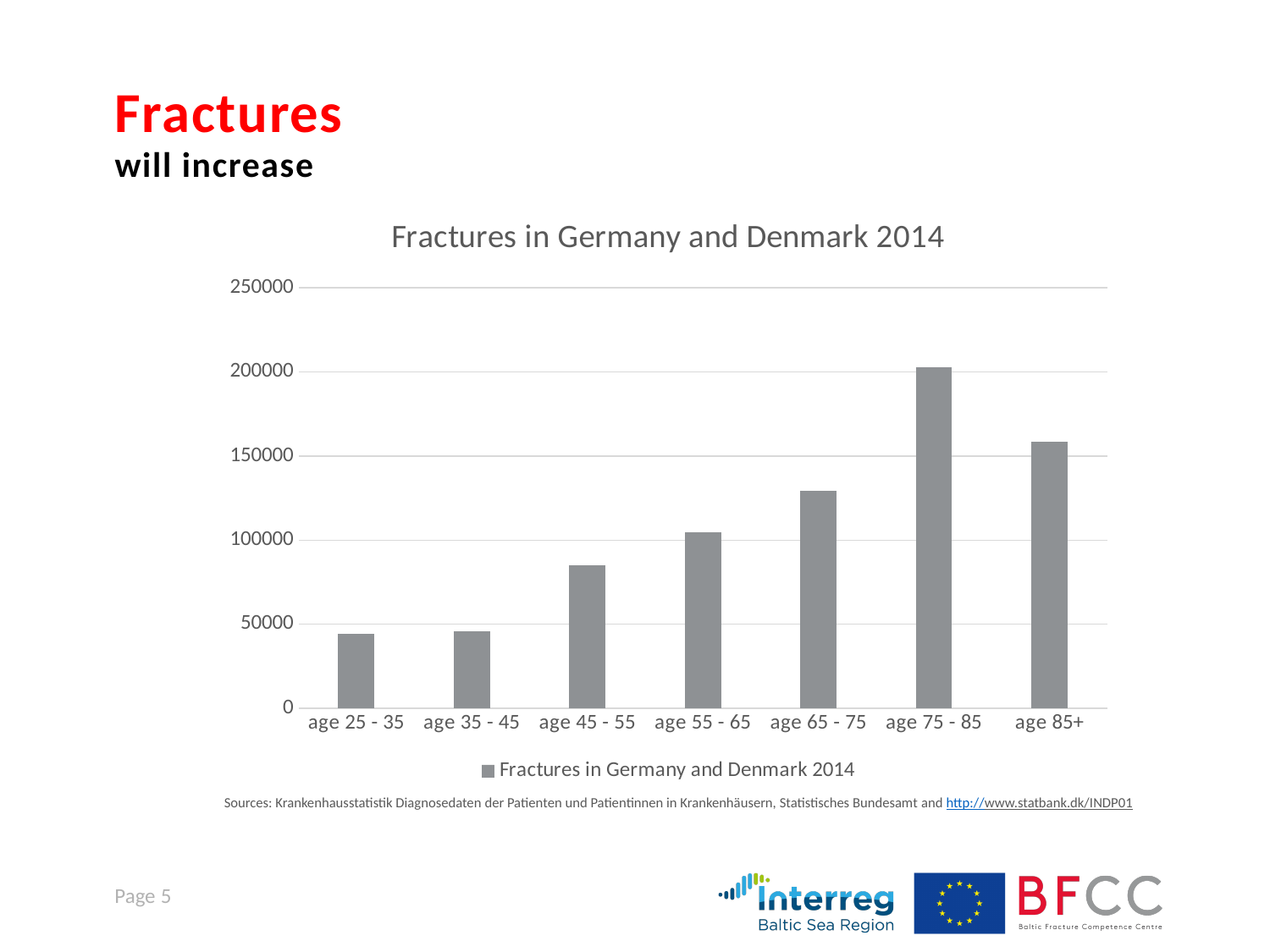
Is the value for age 45 - 55 greater or less than 100000? less How many age categories are shown on the x axis? 7 Is the value for age 85+ greater or less than 150000? greater Which is larger, the value for age 75 - 85 or the value for age 85+? age 75 - 85 Do the values rise or fall from age 25 - 35 to age 75 - 85? rise Is the value for age 25 - 35 greater or less than 50000? less How many series does the legend list? 1 What is the title of the chart? Fractures in Germany and Denmark 2014 Which age category has the highest number of fractures? age 75 - 85 What kind of chart is shown on the slide? bar chart